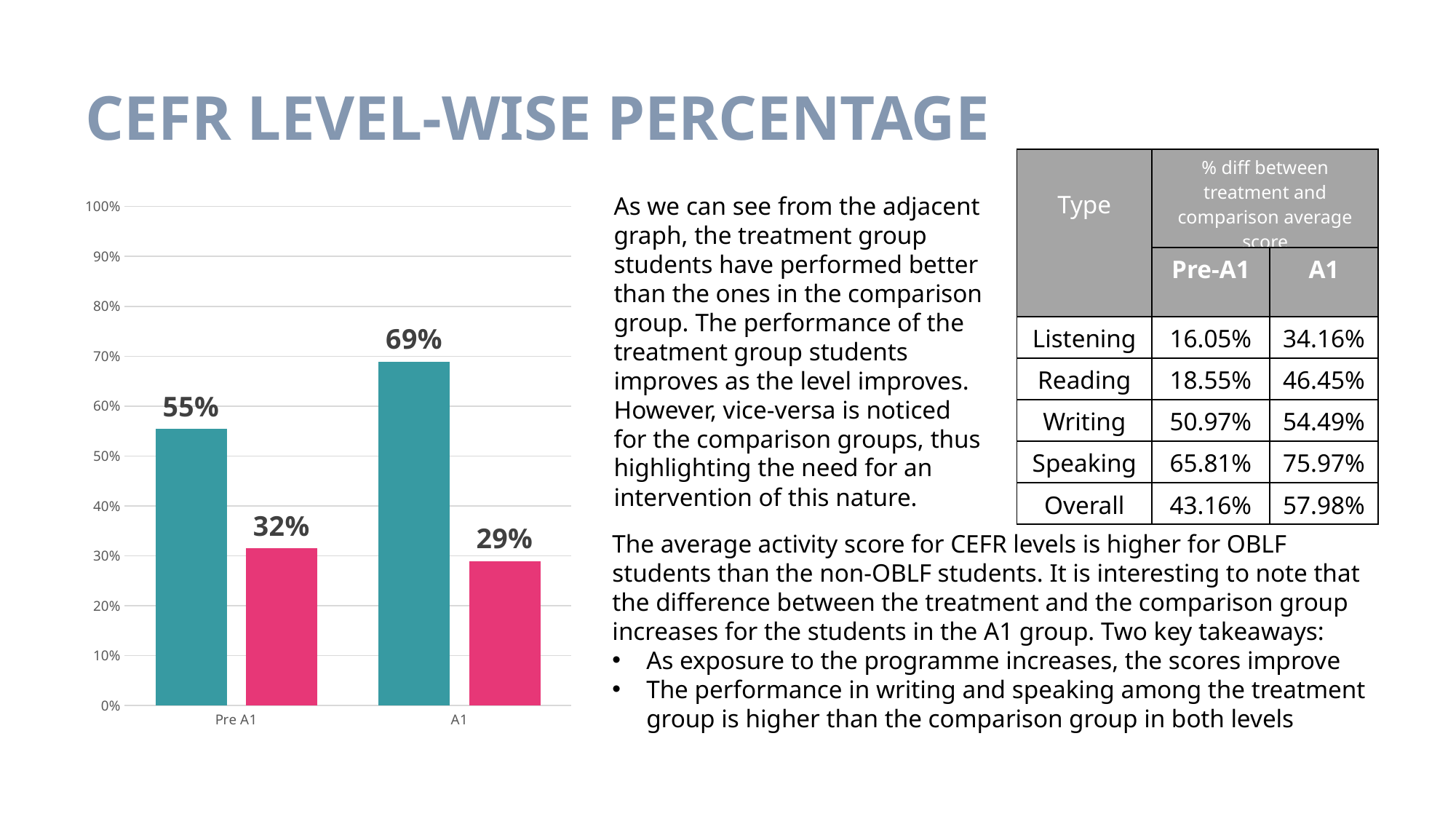
Which is larger: the pink bar for Pre A1 or the pink bar for A1? the pink bar for Pre A1 What is the value of the teal bar for A1? 69% What is the value of the pink bar for A1? 29% Do the teal bars rise or fall from Pre A1 to A1? rise What is the difference between the teal bar and the pink bar for A1? 40% Which bar has the highest value in the chart? the teal bar for A1 (69%) Which bar has the lowest value in the chart? the pink bar for A1 (29%) What type of chart is shown on the slide? bar chart What is the title of the slide containing the chart? CEFR LEVEL-WISE PERCENTAGE How many categories are shown on the x axis of the chart? 2 What is the value of the pink bar for Pre A1? 32% What is the value of the teal bar for Pre A1? 55%